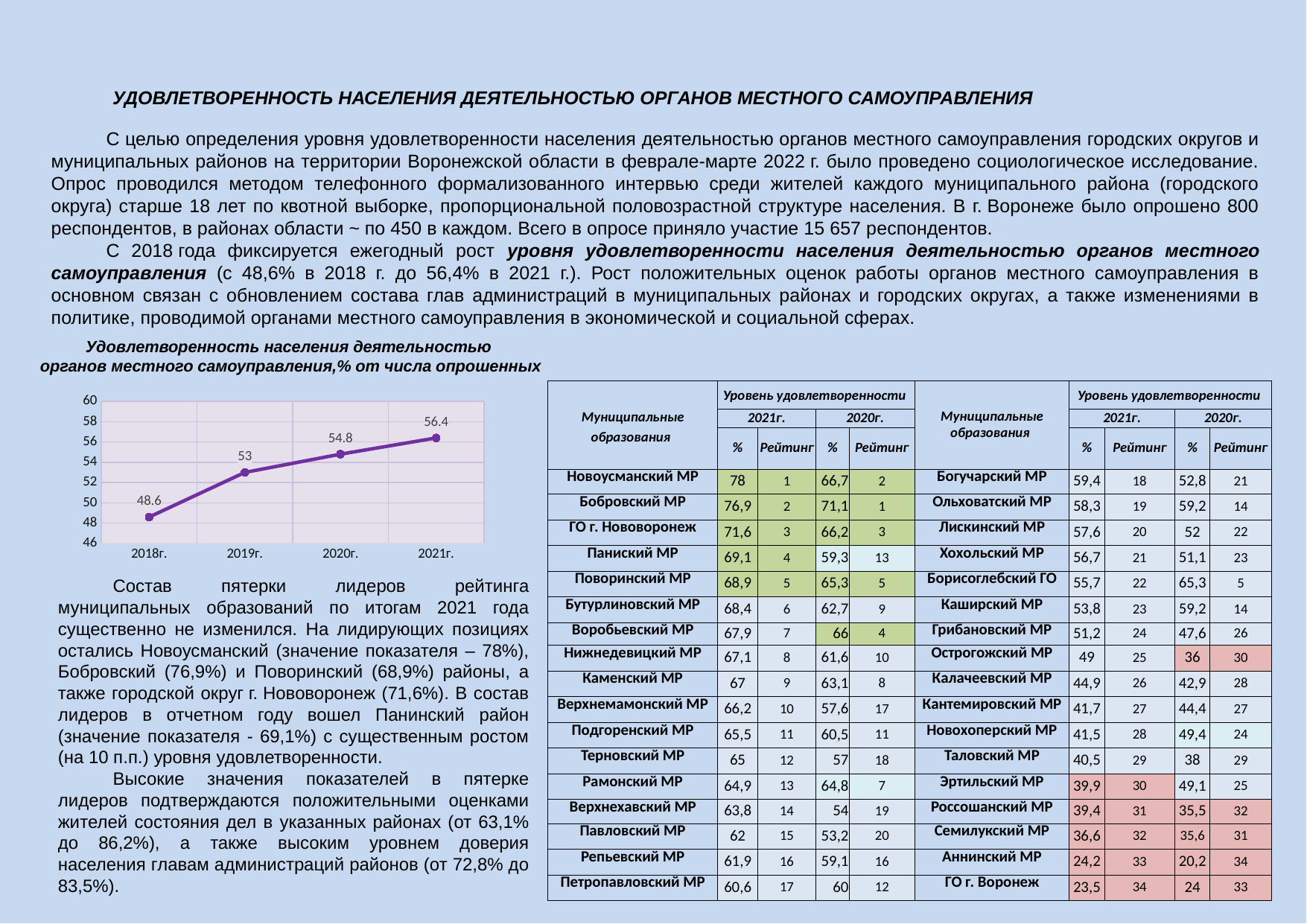
What is the difference between the values for 2021г. and 2018г. in the line chart? 7.8 What is the difference between the values for 2020г. and 2019г. in the line chart? 1.8 What is the value for 2020г. in the line chart? 54.8 How many data points are plotted in the line chart? 4 Do the values in the line chart rise or fall from 2018г. to 2021г.? rise Which year has the lowest value in the line chart? 2018г. What type of chart is shown on the slide? line chart Which is larger in the line chart, the value for 2019г. or the value for 2020г.? 2020г. What is the value for 2019г. in the line chart? 53 Which year has the highest value in the line chart? 2021г. What is the value for 2018г. in the line chart? 48.6 What is the value for 2021г. in the line chart? 56.4